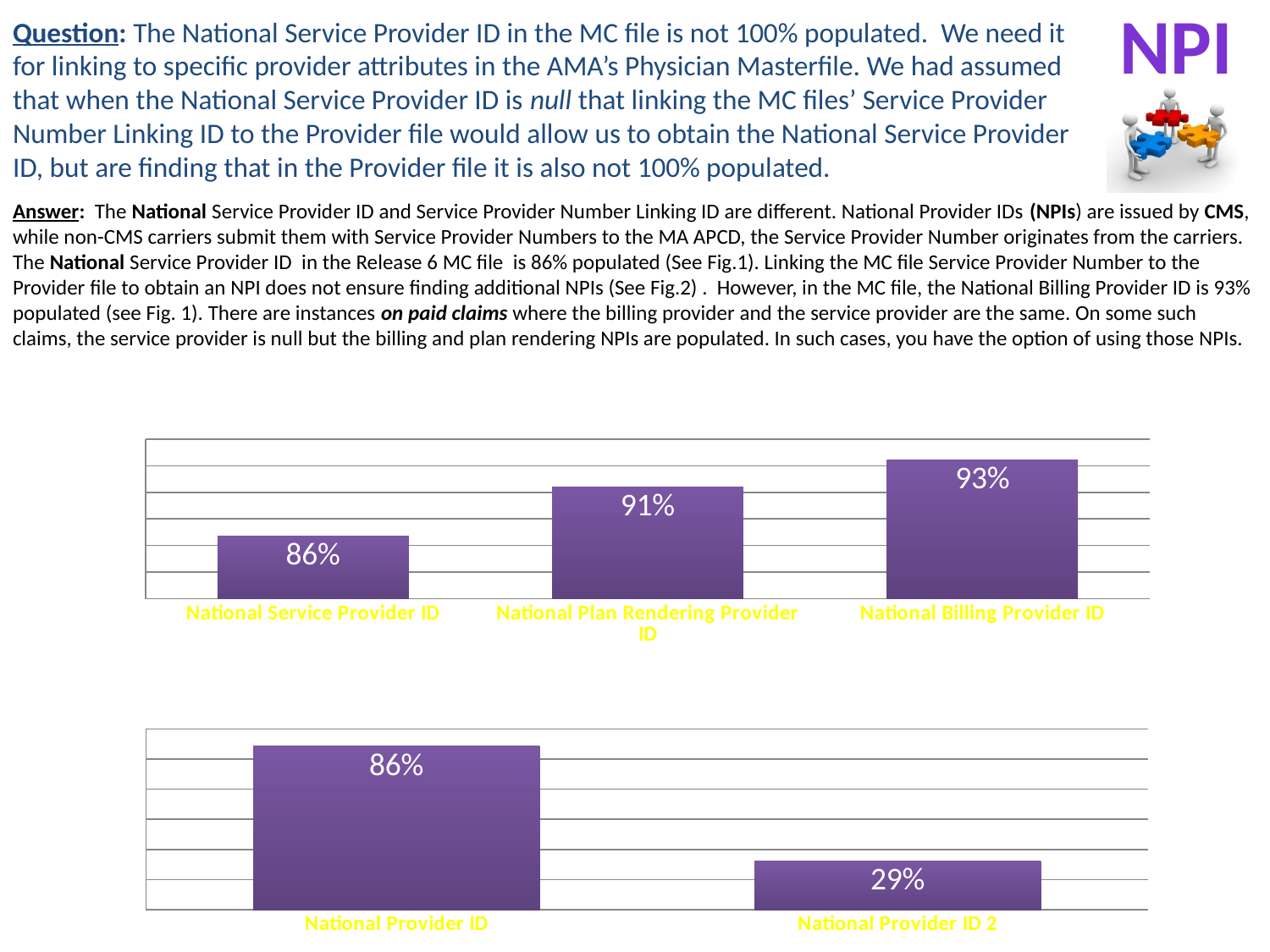
In the top chart, what is the difference between National Billing Provider ID and National Service Provider ID? 7% In the top chart, what is the value for National Plan Rendering Provider ID? 91% In the bottom chart, what is the value for National Provider ID 2? 29% In the top chart, what is the value for National Billing Provider ID? 93% In the top chart, which category has the highest value? National Billing Provider ID In the bottom chart, which is larger, National Provider ID or National Provider ID 2? National Provider ID In the top chart, do the values rise or fall from left to right? rise What kind of chart is the bottom chart? bar chart In the top chart, which category has the lowest value? National Service Provider ID In the top chart, what is the value for National Service Provider ID? 86% In the top chart, how many categories are shown? 3 In the bottom chart, what is the difference between National Provider ID and National Provider ID 2? 57%